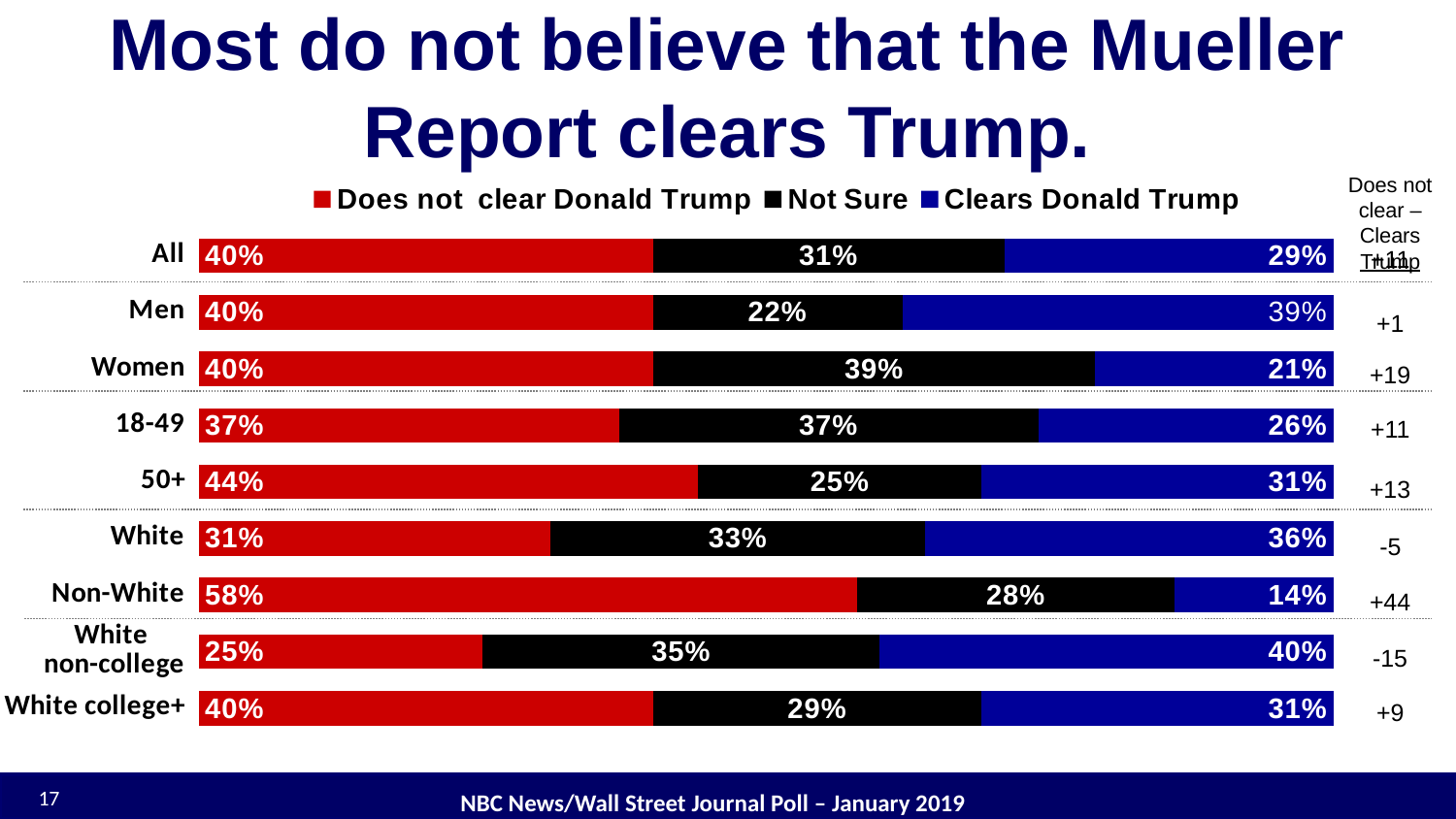
What kind of chart is shown on the slide? Stacked bar chart What is the 'Not Sure' value for Women? 39% Which is larger for White non-college respondents: 'Does not clear Donald Trump' or 'Clears Donald Trump'? Clears Donald Trump How many groups (categories) are shown in the chart? 9 Which group has the highest 'Does not clear Donald Trump' value? Non-White What percentage of Men say the Mueller Report clears Donald Trump? 39% How many series does the legend list? 3 Which colour represents the 'Not Sure' series in the chart? Black What percentage of Non-White respondents say the Mueller Report does not clear Donald Trump? 58% What is the difference between the 'Does not clear Donald Trump' and 'Clears Donald Trump' values for the 50+ group? 13% Which group has the lowest 'Clears Donald Trump' value? Non-White What is the total of the stacked bar for the 18-49 group? 100%